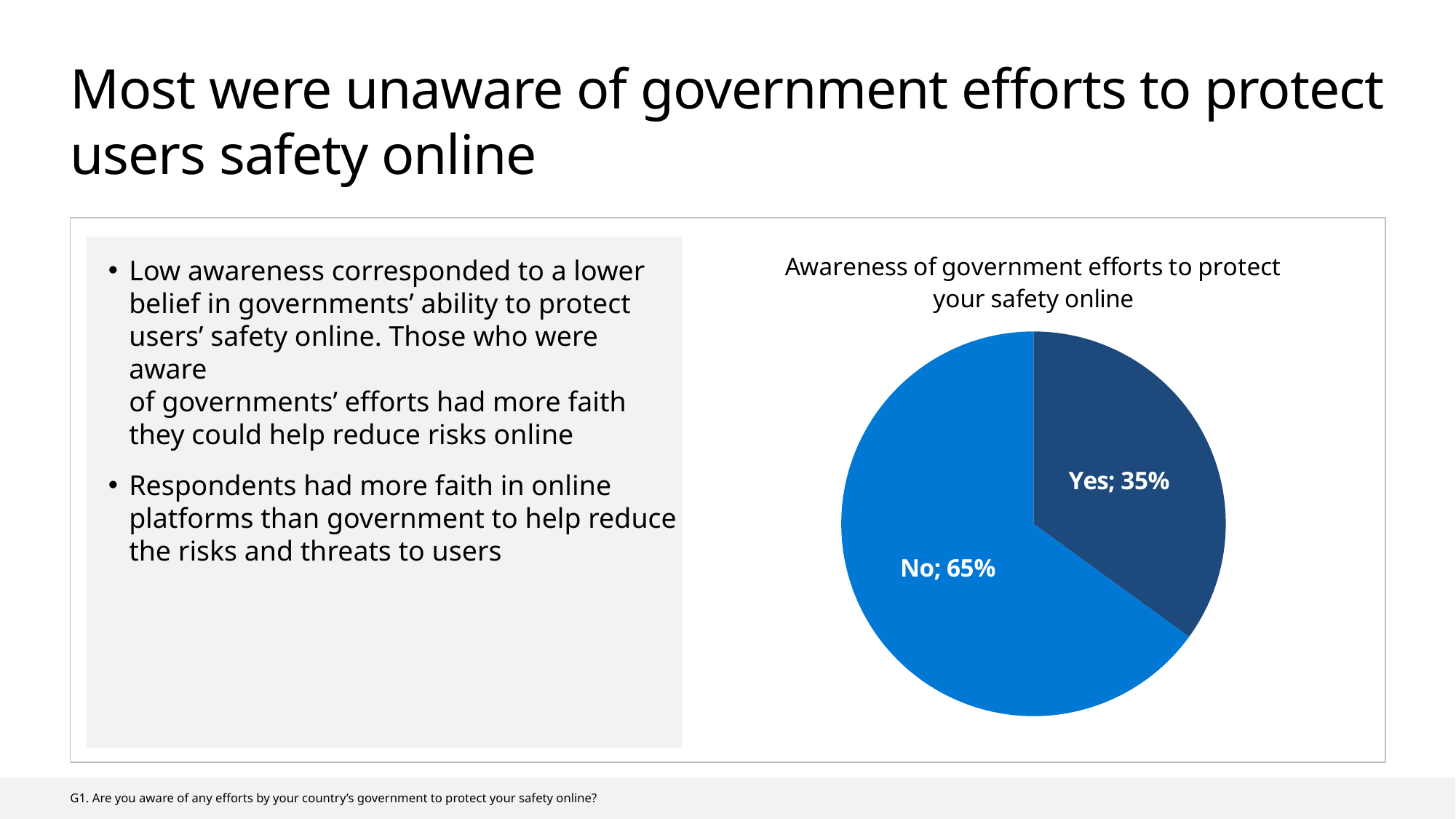
How many slices does the pie chart have? 2 Which is larger, the "Yes" slice or the "No" slice? No What kind of chart is shown on the slide? pie chart What share of the pie does the "No" slice represent? 65% Which slice is shown in the darker blue colour? Yes What percentage of respondents answered "No"? 65% What percentage of respondents answered "Yes"? 35% What is the title of the chart? Awareness of government efforts to protect your safety online Which slice of the pie is the smallest? Yes Which slice of the pie is the largest? No What is the difference in percentage points between the "No" and "Yes" slices? 30